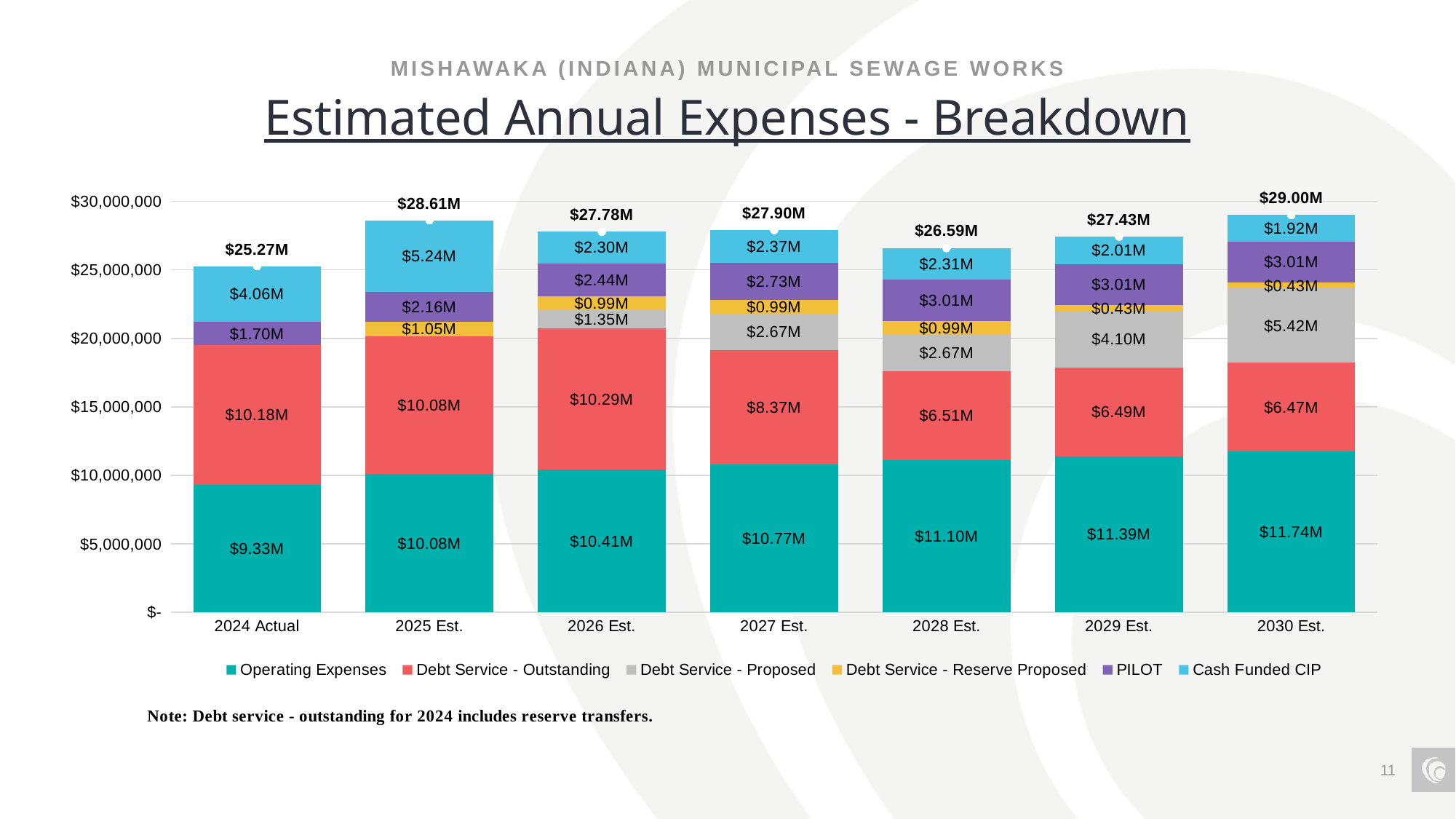
What is the Operating Expenses value for 2024 Actual? $9.33M Which is larger, the Debt Service - Outstanding value for 2026 Est. or for 2027 Est.? 2026 Est. What is the total estimated annual expense for 2030 Est.? $29.00M Do the Operating Expenses values rise or fall from 2024 Actual to 2030 Est.? Rise How many series does the legend list? 6 What is the Debt Service - Proposed value for 2029 Est.? $4.10M How many years are shown on the x axis? 7 Which year has the highest Operating Expenses value? 2030 Est. What is the Cash Funded CIP value for 2025 Est.? $5.24M Which year has the lowest total annual expenses? 2024 Actual What kind of chart is shown on the slide? Stacked bar chart What is the difference between the Operating Expenses values for 2030 Est. and 2024 Actual? $2.41M